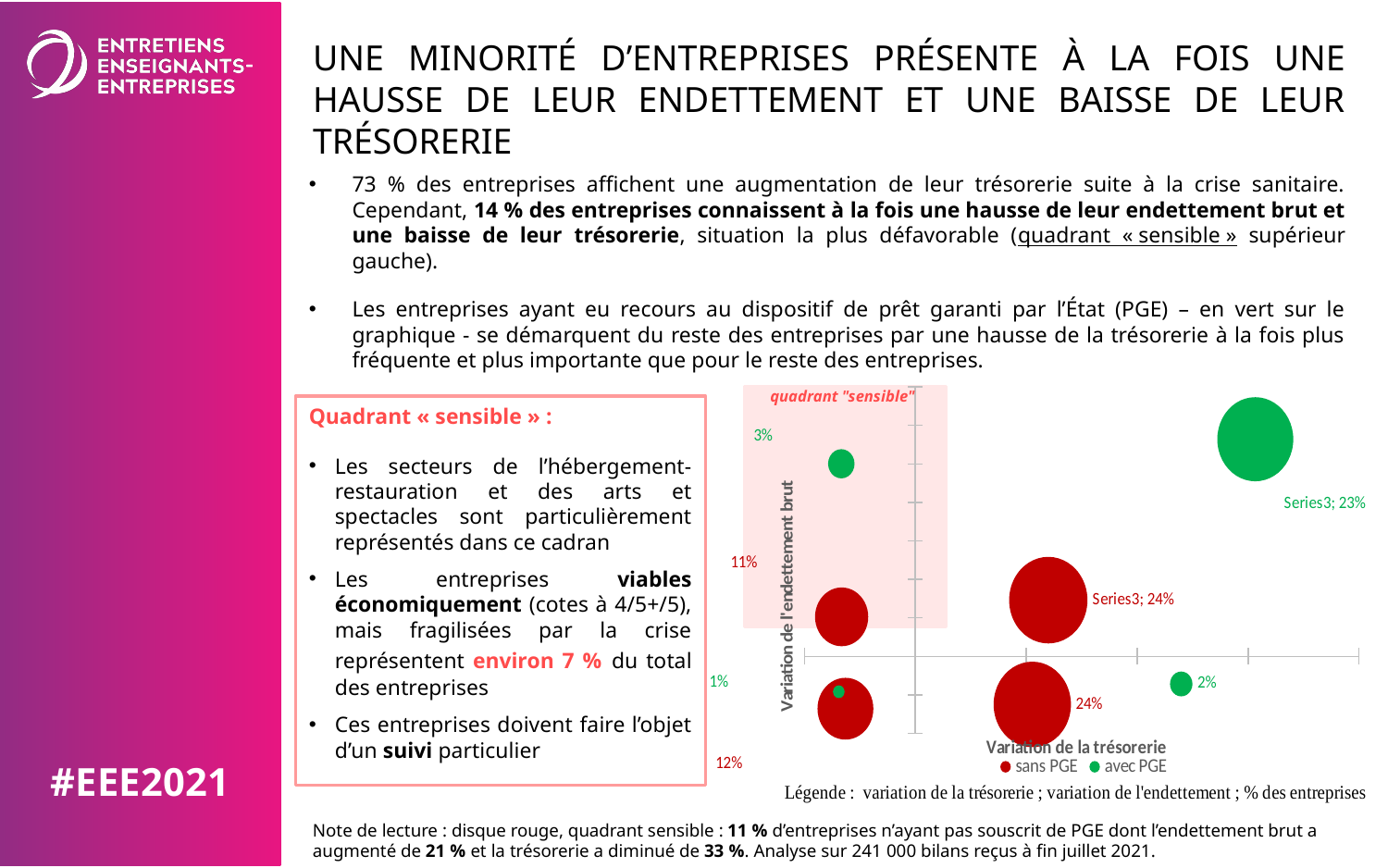
What are the two series named in the chart legend? sans PGE and avec PGE What is the difference in percentage points between the red bubble (11%) and the green bubble (3%) in the upper-left quadrant of the chart? 8 percentage points Which bubble has the smallest labelled percentage on the chart? The green bubble labelled 1% What is the title of the horizontal axis of the chart? Variation de la trésorerie How many series does the chart legend list? 2 How many bubbles are plotted on the chart? 8 What percentage is labelled on the red bubble in the upper-left (quadrant « sensible ») area of the chart? 11% In the upper-left quadrant of the chart, which bubble is larger: the red one (sans PGE) or the green one (avec PGE)? The red one (sans PGE) What percentage is labelled on the green bubble in the upper-left (quadrant « sensible ») area of the chart? 3% What kind of chart is shown on the slide? Bubble chart What percentage is labelled on the green bubble in the lower-right area of the chart? 2% What percentage is labelled on the red bubble in the lower-left area of the chart? 12%